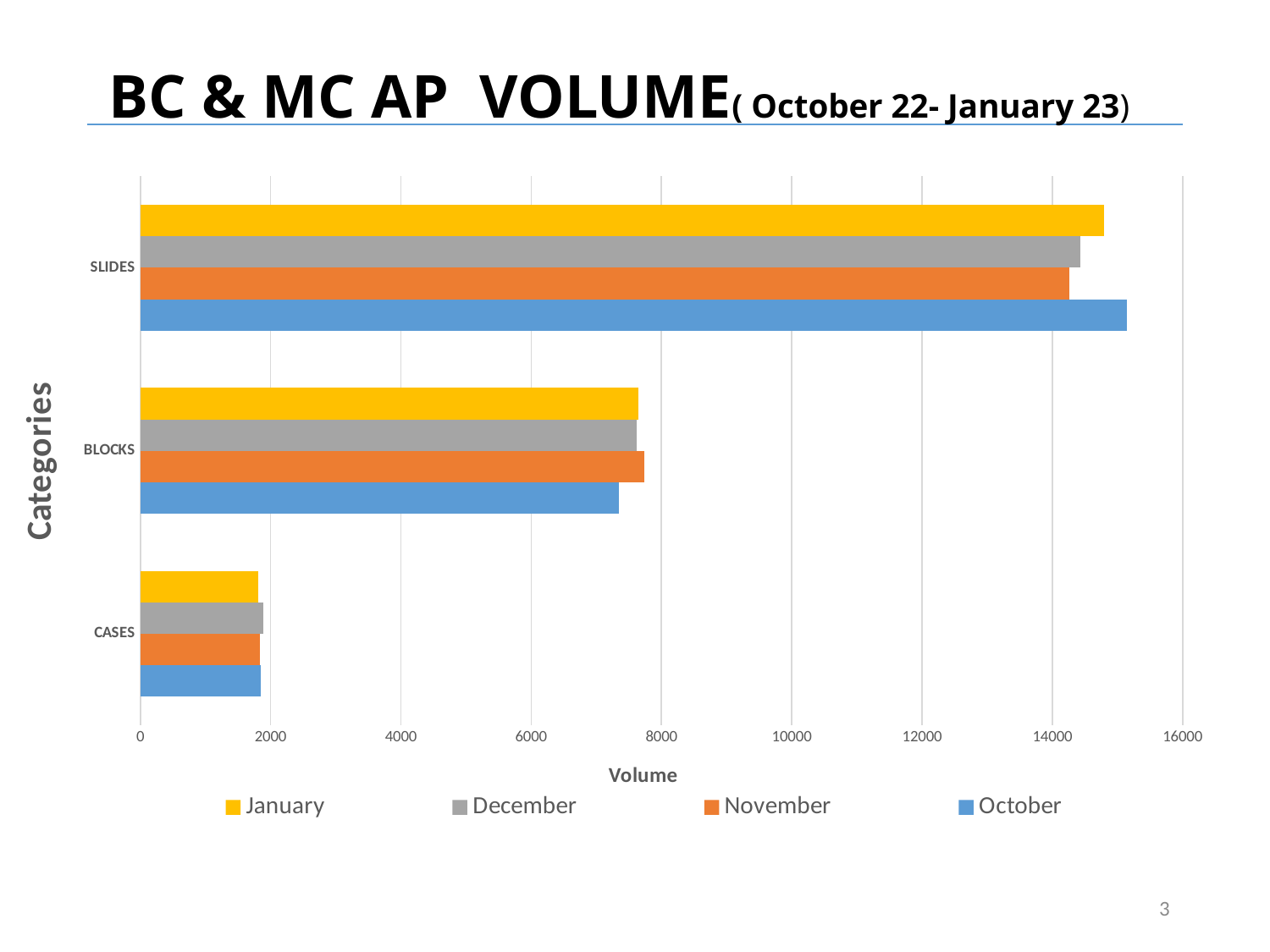
Is the November volume for BLOCKS greater or less than 8000? less How many categories are shown on the vertical axis of the chart? 3 For SLIDES, which month has the highest volume? October Is the January volume for CASES greater or less than 2000? less Which is larger for SLIDES: the October volume or the November volume? October What is the label of the horizontal axis? Volume Which category has the lowest volume across all months? CASES Is the October volume for SLIDES greater or less than 14000? greater What kind of chart is shown on the slide? bar chart Which category has the highest volume across all months? SLIDES For BLOCKS, which month has the lowest volume? October How many series does the legend list? 4